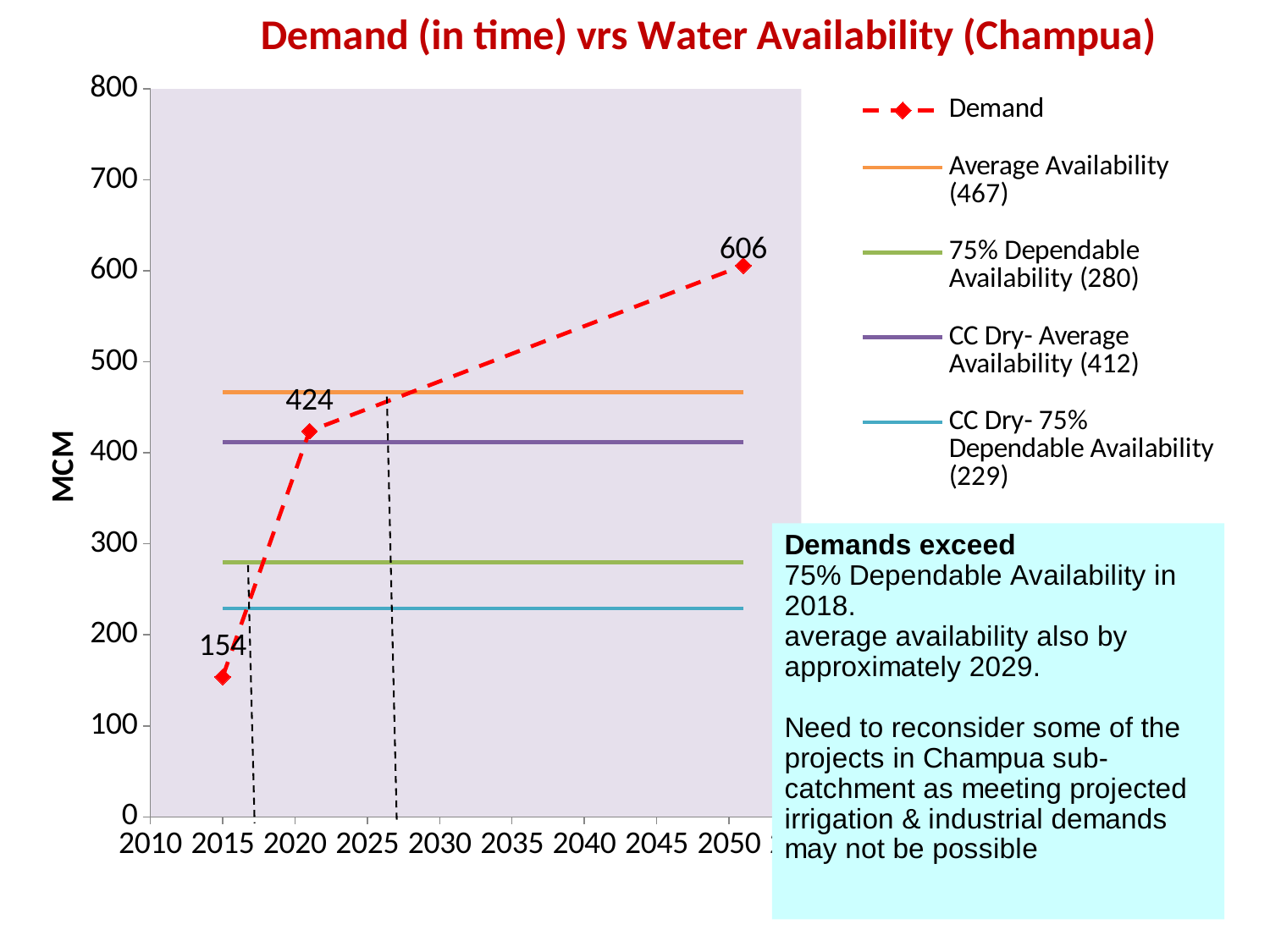
What is the difference between the highest and lowest labelled Demand values? 452 Which is larger, Average Availability or CC Dry- Average Availability? Average Availability What value does the legend give for Average Availability? 467 What type of chart is shown on the slide? line chart What is the lowest labelled Demand value? 154 How many data points are plotted for the Demand series? 3 Which availability line has the lowest value? CC Dry- 75% Dependable Availability (229) What is the label on the y axis? MCM Does the Demand series rise or fall over time along the x axis? rises What is the highest labelled Demand value? 606 How many series does the legend list? 5 What is the difference between the Demand values labelled 424 and 154? 270